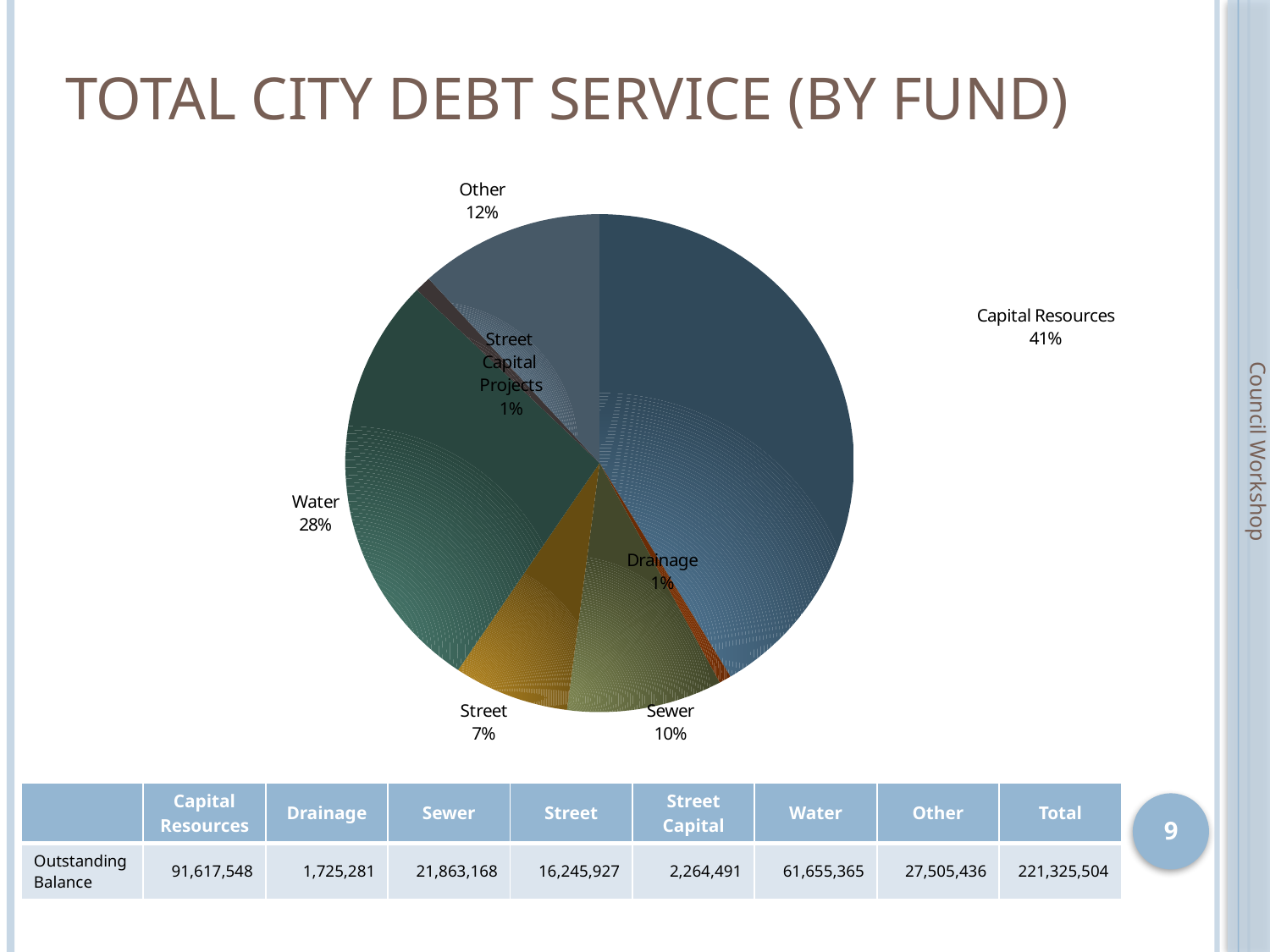
What percentage is shown for the Street slice? 7% What share of the pie does Capital Resources represent? 41% What percentage is shown for the Other slice? 12% Which fund has the largest slice of the pie? Capital Resources How many slices does the pie chart have? 7 What percentage is shown for the Drainage slice? 1% What kind of chart is shown on the slide? pie chart What percentage is shown for the Sewer slice? 10% What share of the pie does Water represent? 28% What is the title of the chart? TOTAL CITY DEBT SERVICE (BY FUND) What is the difference in percentage points between the Capital Resources slice and the Water slice? 13% Which slice is larger, Water or Sewer? Water